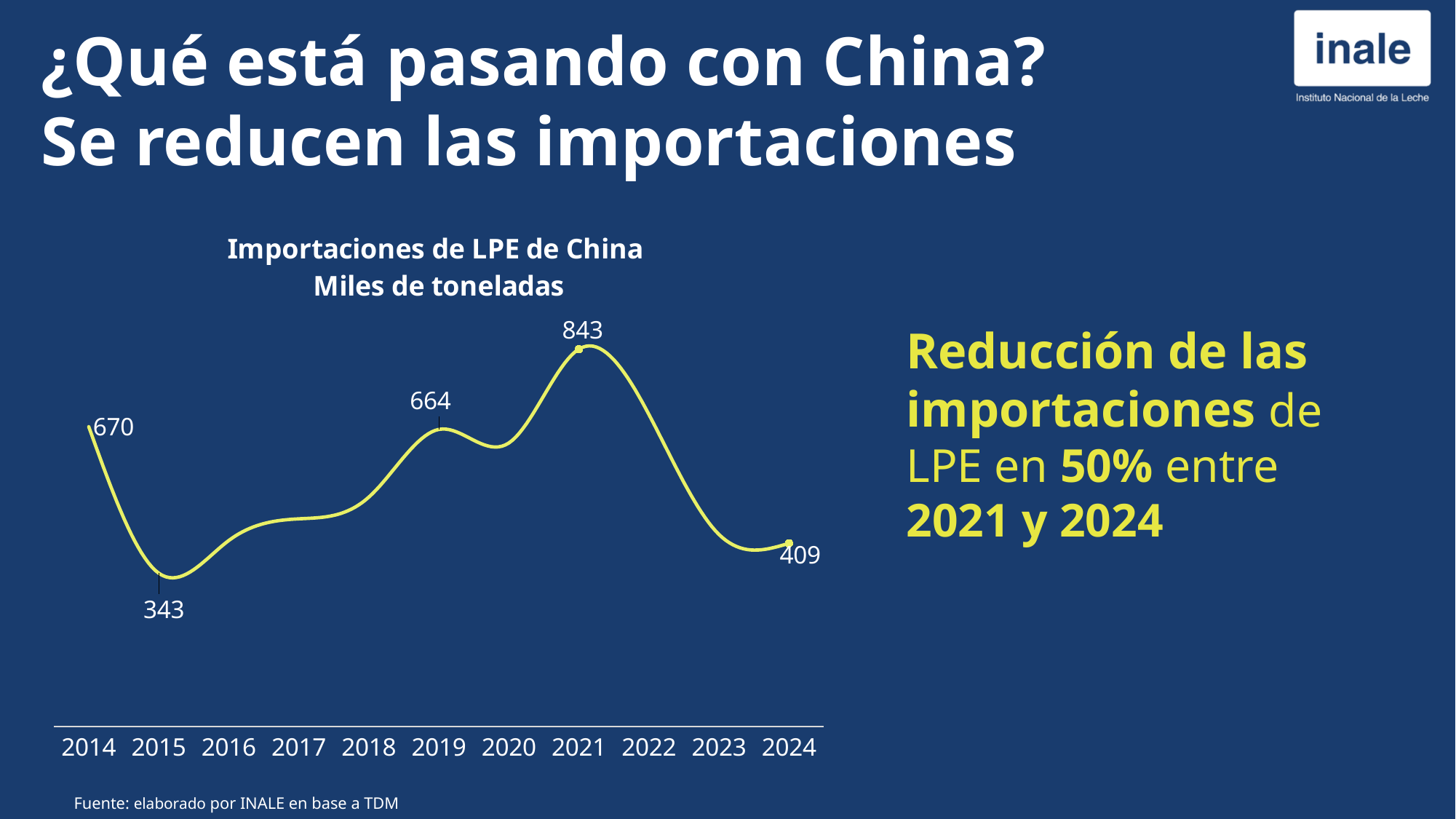
What is the difference between the 2014 and 2015 values? 327 What is the difference between the 2021 and 2024 values? 434 Which year has the lowest value of LPE imports? 2015 Do the values rise or fall between 2021 and 2024? fall What was the value of China's LPE imports in 2021? 843 Which year has the highest value of LPE imports? 2021 Which is larger, the value for 2014 or the value for 2019? 2014 What was the value of China's LPE imports in 2024? 409 What was the value of China's LPE imports in 2019? 664 How many years are shown on the x axis? 11 What was the value of China's LPE imports in 2015? 343 What kind of chart is shown on the slide? line chart